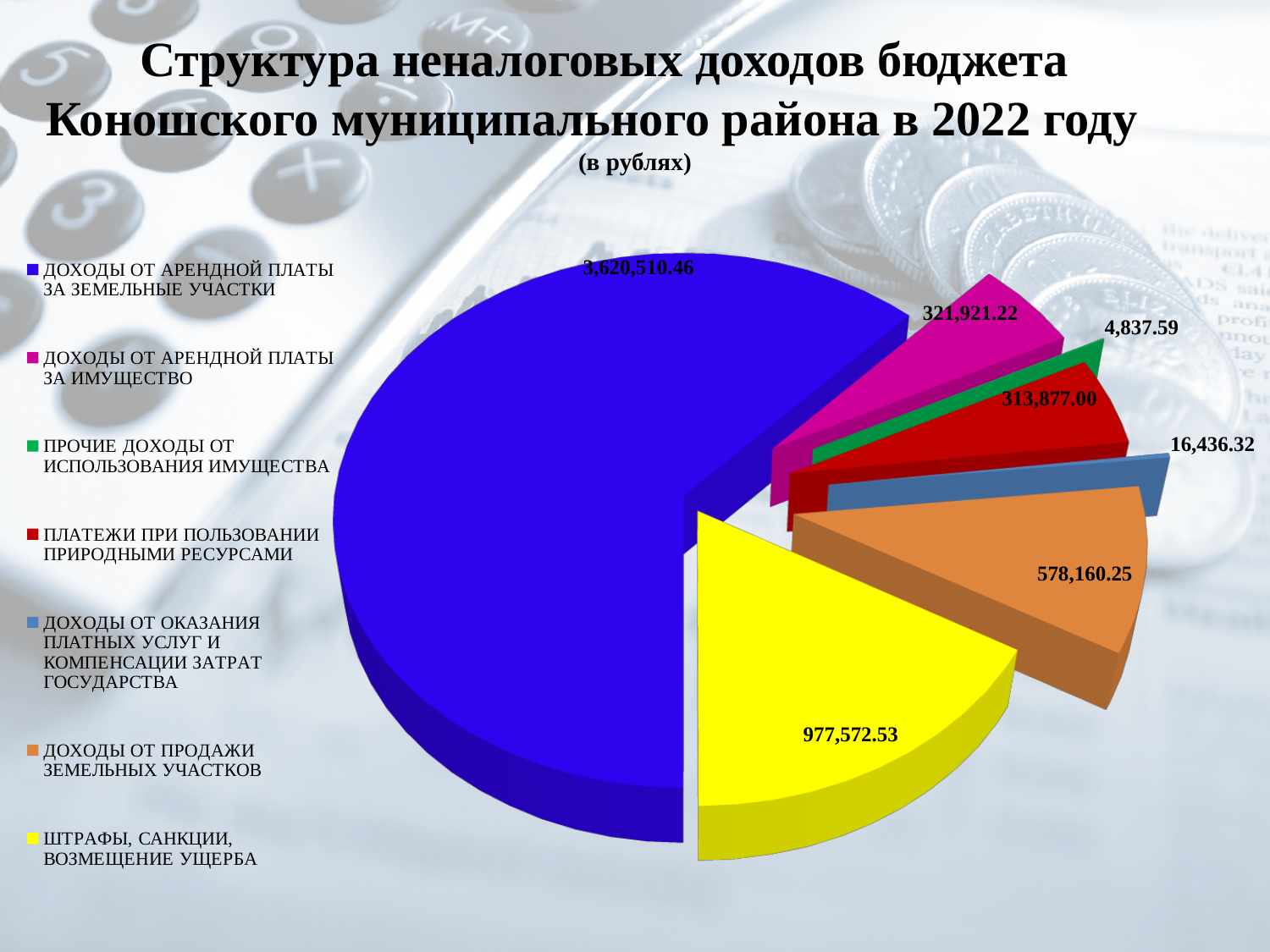
What is the difference between the values for ШТРАФЫ, САНКЦИИ, ВОЗМЕЩЕНИЕ УЩЕРБА and ДОХОДЫ ОТ ПРОДАЖИ ЗЕМЕЛЬНЫХ УЧАСТКОВ? 399,412.28 Which is larger: ДОХОДЫ ОТ АРЕНДНОЙ ПЛАТЫ ЗА ИМУЩЕСТВО or ПЛАТЕЖИ ПРИ ПОЛЬЗОВАНИИ ПРИРОДНЫМИ РЕСУРСАМИ? ДОХОДЫ ОТ АРЕНДНОЙ ПЛАТЫ ЗА ИМУЩЕСТВО How many entries does the legend list? 7 What is the value for ДОХОДЫ ОТ АРЕНДНОЙ ПЛАТЫ ЗА ЗЕМЕЛЬНЫЕ УЧАСТКИ? 3,620,510.46 What is the value for ПРОЧИЕ ДОХОДЫ ОТ ИСПОЛЬЗОВАНИЯ ИМУЩЕСТВА? 4,837.59 What is the value for ШТРАФЫ, САНКЦИИ, ВОЗМЕЩЕНИЕ УЩЕРБА? 977,572.53 What colour is the slice for ШТРАФЫ, САНКЦИИ, ВОЗМЕЩЕНИЕ УЩЕРБА? Yellow How many slices does the pie chart have? 7 Which category has the largest slice of the pie? ДОХОДЫ ОТ АРЕНДНОЙ ПЛАТЫ ЗА ЗЕМЕЛЬНЫЕ УЧАСТКИ What type of chart is shown on the slide? Pie chart Which category has the smallest slice of the pie? ПРОЧИЕ ДОХОДЫ ОТ ИСПОЛЬЗОВАНИЯ ИМУЩЕСТВА What is the value for ДОХОДЫ ОТ ПРОДАЖИ ЗЕМЕЛЬНЫХ УЧАСТКОВ? 578,160.25